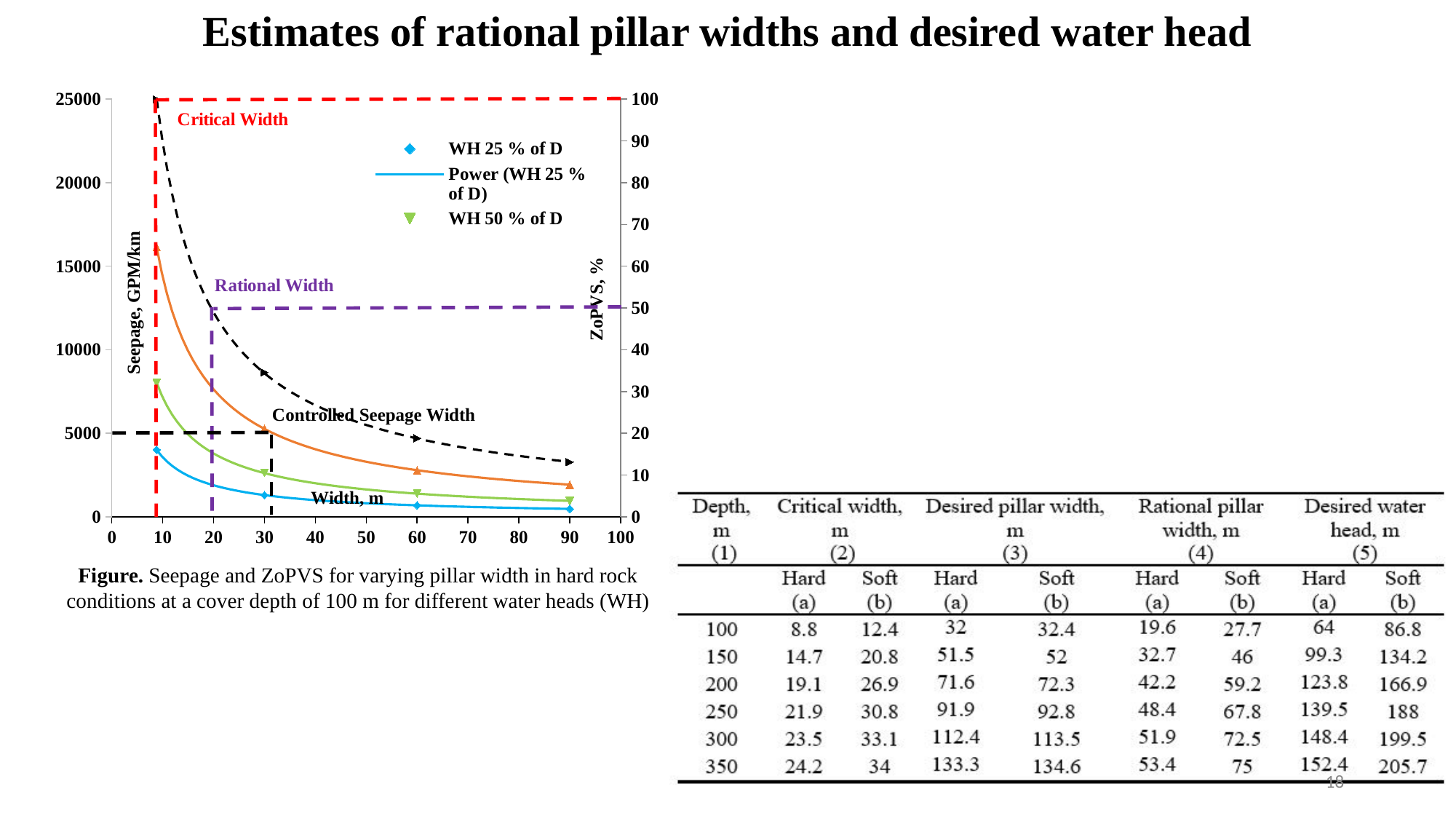
Do the seepage values rise or fall as pillar width increases along the x axis? fall What is the label of the left vertical axis of the chart? Seepage, GPM/km Is the seepage value for WH 50 % of D at a width of 60 m greater or less than 5000? less At what seepage value on the left axis is the Controlled Seepage Width dashed line drawn? 5000 At a width of 10 m, which series has the higher seepage, WH 25 % of D or WH 50 % of D? WH 50 % of D Is the seepage value for WH 50 % of D at a width of 10 m greater or less than 5000? greater What kind of chart is shown on the left of the slide? line chart Is the seepage value for WH 25 % of D at a width of 10 m greater or less than 5000? less What is the label of the right vertical axis of the chart? ZoPVS, % At what ZoPVS percentage on the right axis is the Rational Width dashed line drawn? 50 How many entries does the chart legend list? 3